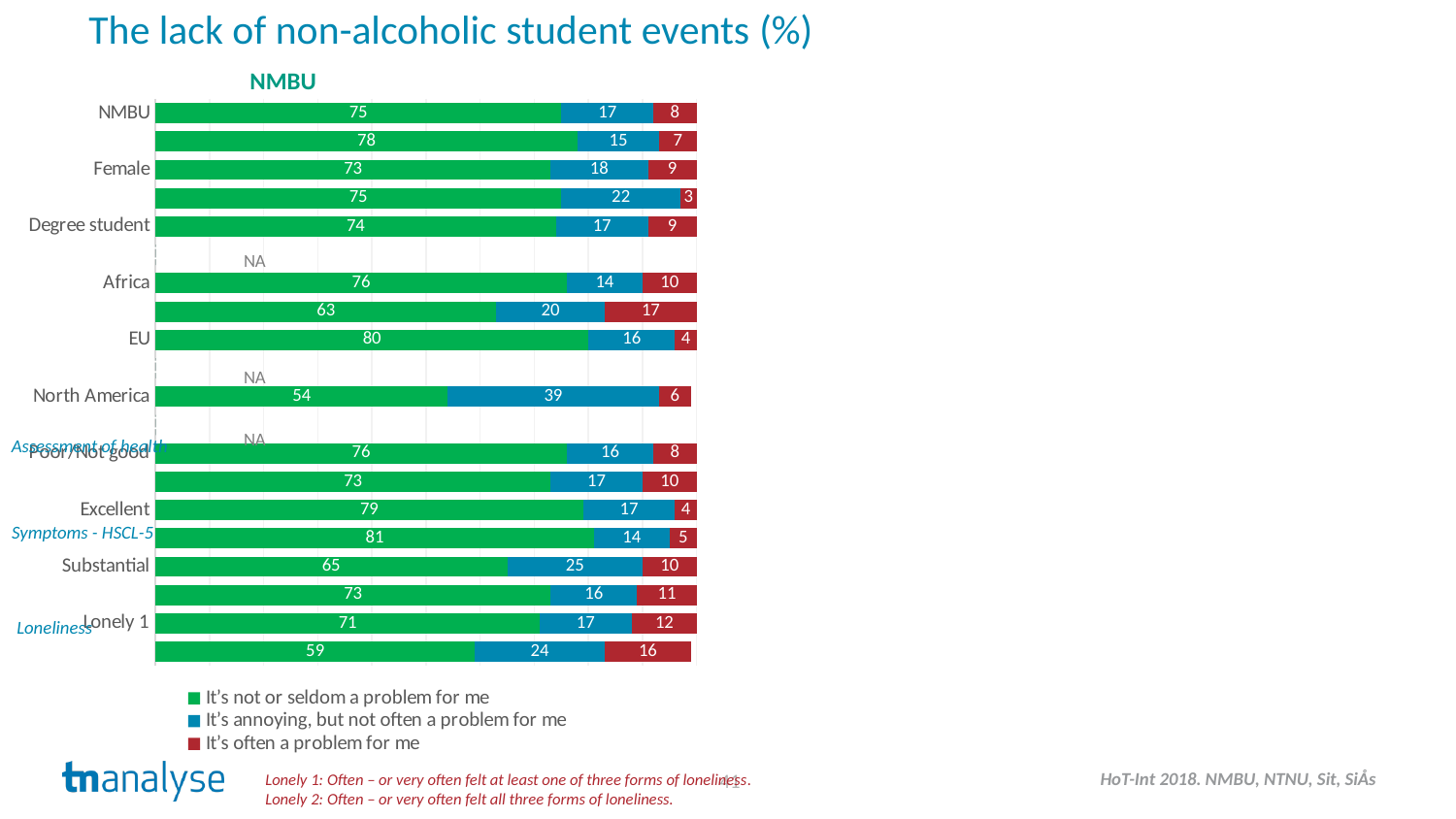
Which is larger: the "It's often a problem for me" value for Africa or for EU? Africa How many series does the legend list? 3 What is the difference between the "It's not or seldom a problem for me" values for EU and North America? 26 What is the value of "It's not or seldom a problem for me" for Substantial? 65 What is the value of "It's often a problem for me" for Lonely 1? 12 Among the labelled categories, which has the highest value for "It's not or seldom a problem for me"? EU What is the title of the chart? The lack of non-alcoholic student events (%) What is the value of "It's annoying, but not often a problem for me" for North America? 39 What is the total of the stacked bar for Degree student? 100 What is the value of "It's not or seldom a problem for me" for EU? 80 What kind of chart is shown on the slide? bar chart Among the labelled categories, which has the lowest value for "It's not or seldom a problem for me"? North America